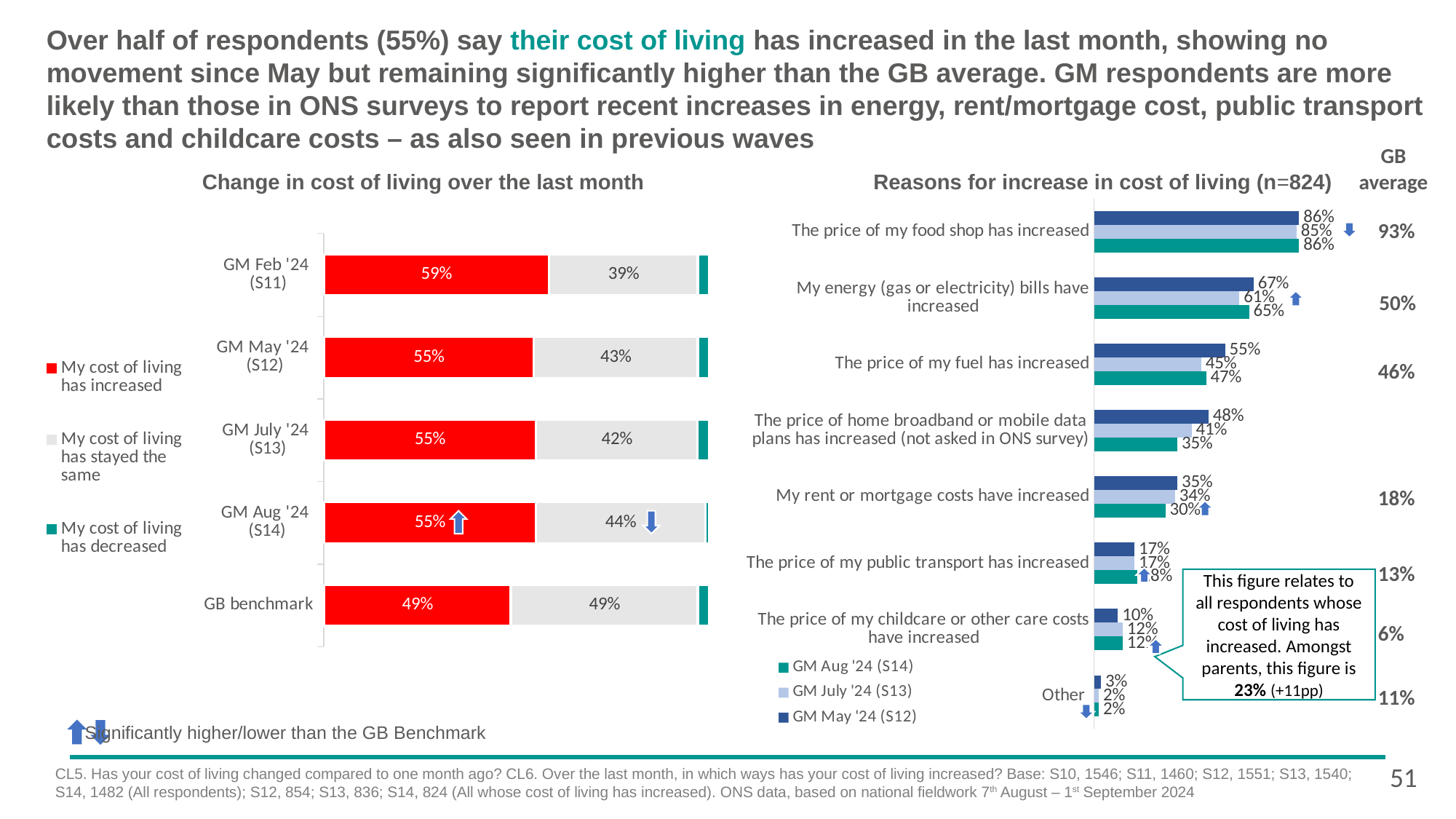
In the 'Reasons for increase in cost of living (n=824)' chart, what is the difference between the GM May '24 (S12) and GM Aug '24 (S14) values for 'The price of home broadband or mobile data plans has increased'? 13 percentage points In the 'Change in cost of living over the last month' chart, what percentage of GM Feb '24 (S11) respondents said their cost of living has increased? 59% In the 'Change in cost of living over the last month' chart, which category has the highest share saying their cost of living has increased? GM Feb '24 (S11) In the 'Change in cost of living over the last month' chart, what percentage of GM Aug '24 (S14) respondents said their cost of living has stayed the same? 44% In the 'Change in cost of living over the last month' chart, how many series does the legend list? 3 In the 'Reasons for increase in cost of living (n=824)' chart, which reason has the highest GM Aug '24 (S14) value? The price of my food shop has increased In the 'Reasons for increase in cost of living (n=824)' chart, what is the GM Aug '24 (S14) value for 'My energy (gas or electricity) bills have increased'? 65% In the 'Reasons for increase in cost of living (n=824)' chart, which is larger for 'The price of my public transport has increased': the GM July '24 (S13) value or the GM Aug '24 (S14) value? GM Aug '24 (S14) In the 'Change in cost of living over the last month' chart, what is the difference between the 'increased' share for GM Feb '24 (S11) and for the GB benchmark? 10 percentage points What type of chart is 'Change in cost of living over the last month'? Stacked bar chart In the 'Reasons for increase in cost of living (n=824)' chart, how many reason categories are plotted? 8 In the 'Reasons for increase in cost of living (n=824)' chart, what is the GM May '24 (S12) value for 'The price of my fuel has increased'? 55%